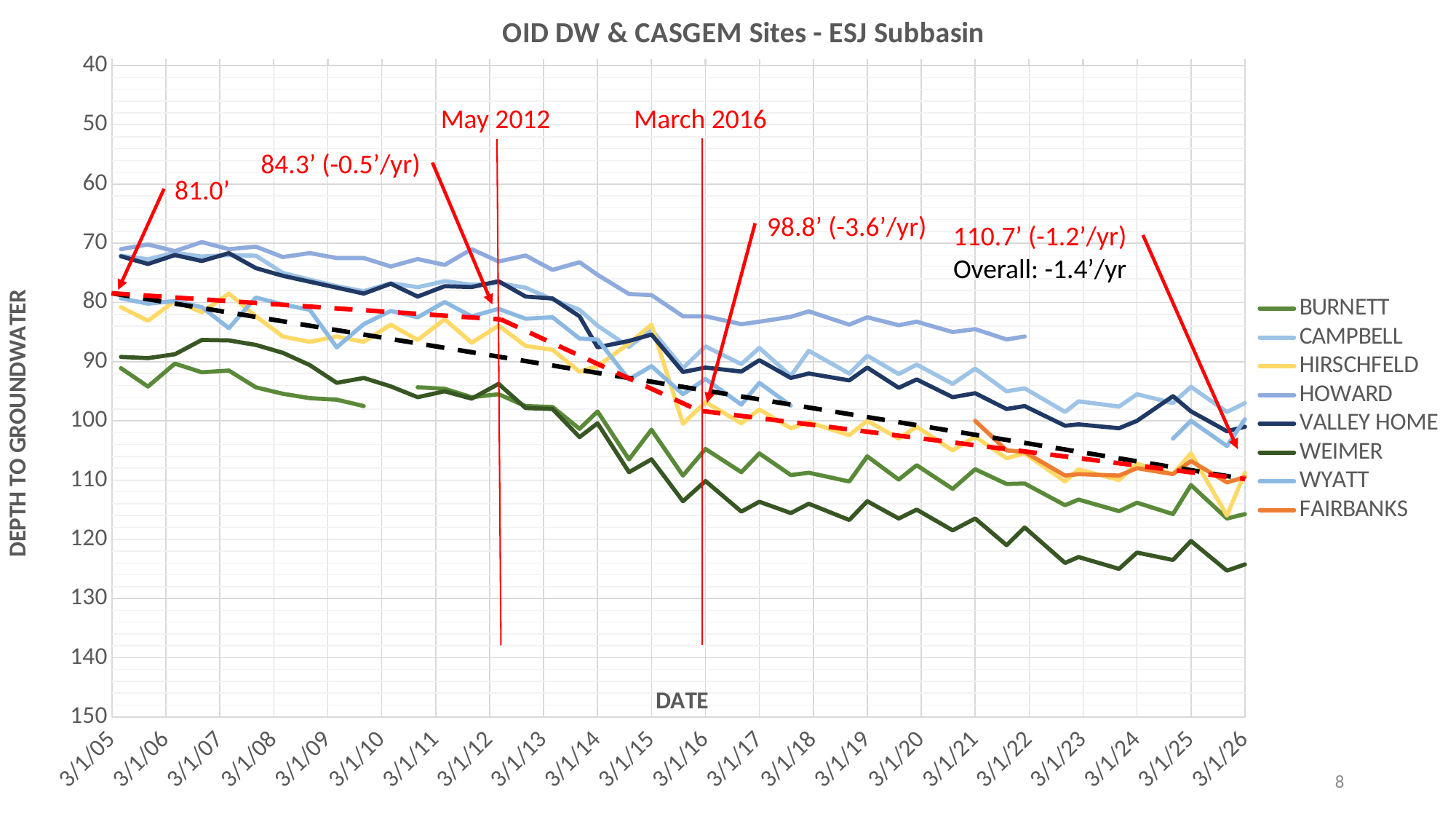
What annotated depth value is shown at the start of the trend line in 2005? 81.0' What annotated depth value is shown at the March 2016 marker? 98.8' What kind of chart is shown on the slide? line chart What overall rate of change is annotated on the chart? -1.4'/yr Which series shows the greatest depth to groundwater at 3/1/26? WEIMER What is the difference between the annotated depth of 110.7' and the annotated depth of 81.0'? 29.7' Does the depth to groundwater for BURNETT increase or decrease from 3/1/05 to 3/1/26? increase Is the depth to groundwater for WEIMER at 3/1/26 greater or less than 120? greater What is the label on the vertical axis of the chart? DEPTH TO GROUNDWATER What rate of change is annotated for the period between May 2012 and March 2016? -3.6'/yr What is the title of the chart? OID DW & CASGEM Sites - ESJ Subbasin How many series does the legend list? 8